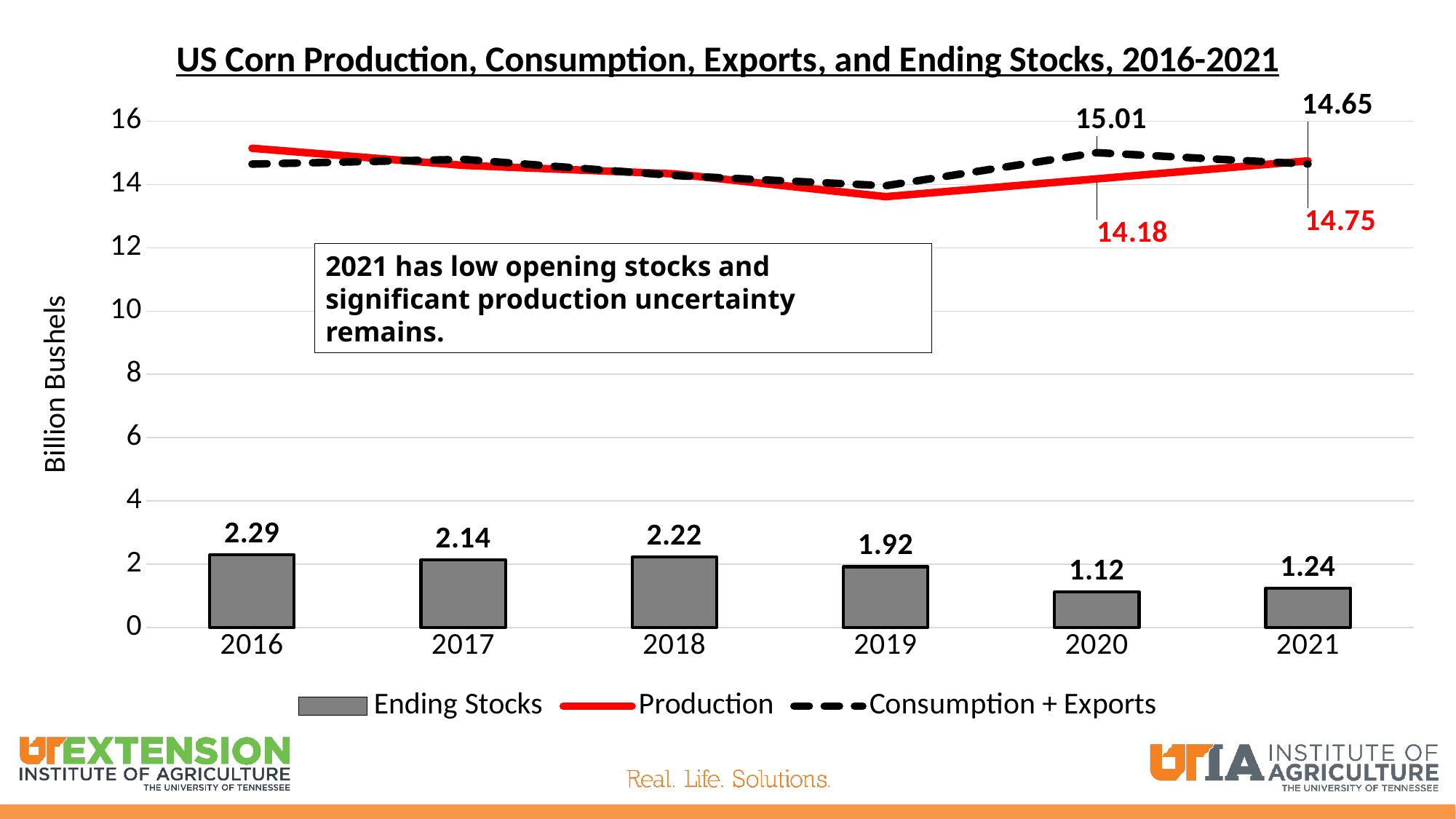
What is the Ending Stocks value for 2016? 2.29 In 2020, which is larger: Production or Consumption + Exports? Consumption + Exports What is the difference between Ending Stocks in 2016 and 2020? 1.17 Which year has the highest Ending Stocks? 2016 Which series is drawn as a dashed black line? Consumption + Exports How many years are shown on the x axis? 6 Which year has the lowest Ending Stocks? 2020 Is the Production value for 2019 greater or less than 14? less How many series does the legend list? 3 What is the Consumption + Exports value for 2021? 14.65 What is the Production value for 2020? 14.18 What is the unit shown on the y axis? Billion Bushels